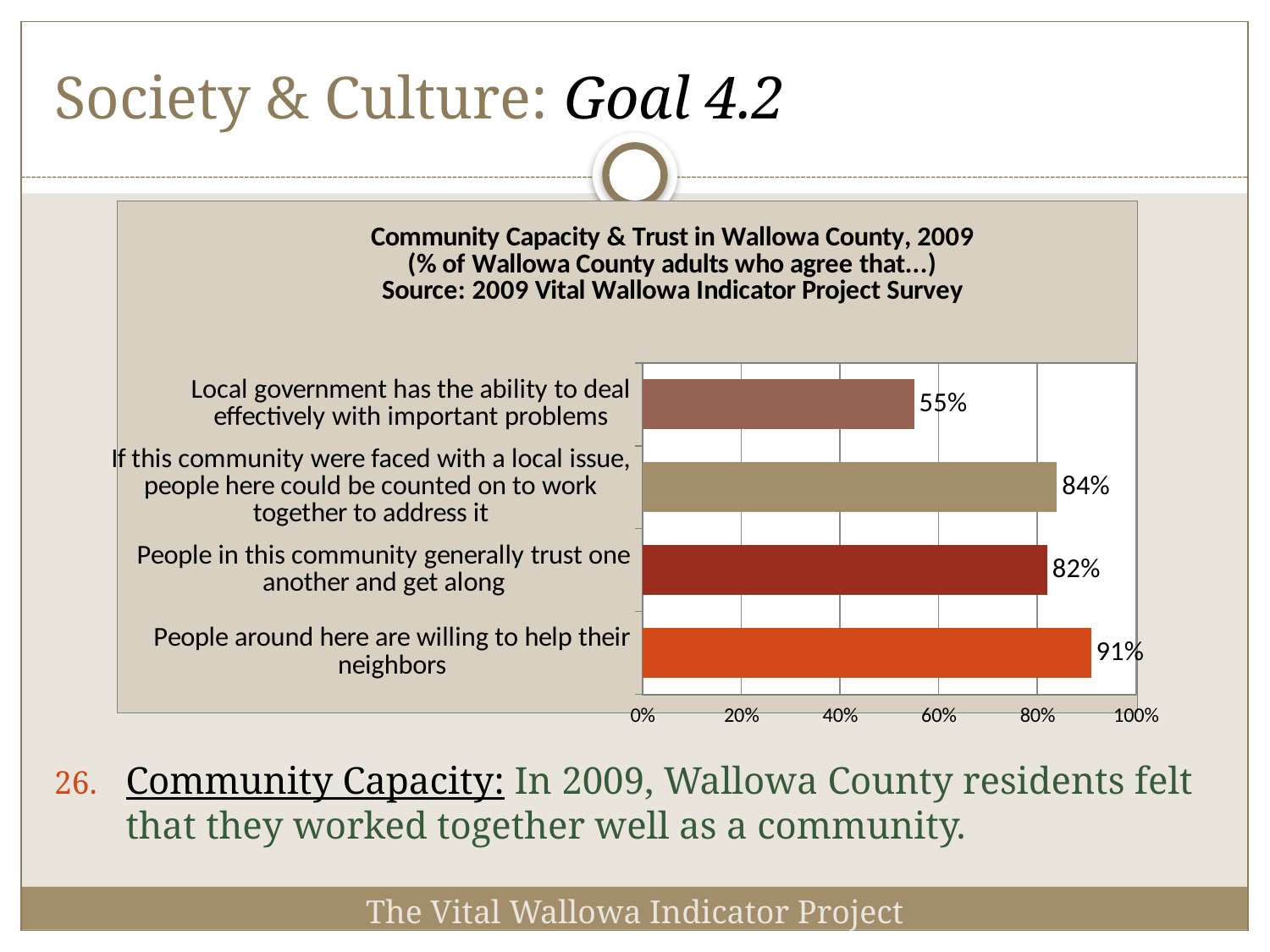
What is the source of the data in the chart? 2009 Vital Wallowa Indicator Project Survey What percentage agree that if this community were faced with a local issue, people here could be counted on to work together to address it? 84% How many statements are shown in the chart? 4 Which has a higher agreement percentage: people could be counted on to work together on a local issue, or people generally trust one another and get along? People could be counted on to work together on a local issue What percentage of Wallowa County adults agree that local government has the ability to deal effectively with important problems? 55% What percentage of Wallowa County adults agree that people around here are willing to help their neighbors? 91% What percentage agree that people in this community generally trust one another and get along? 82% What is the difference in percentage points between agreement that people are willing to help their neighbors and agreement that local government can deal effectively with important problems? 36 Which statement has the lowest percentage of agreement? Local government has the ability to deal effectively with important problems What type of chart is shown on the slide? Bar chart Is the value for local government's ability to deal effectively with important problems greater or less than 60%? less Which statement has the highest percentage of agreement? People around here are willing to help their neighbors